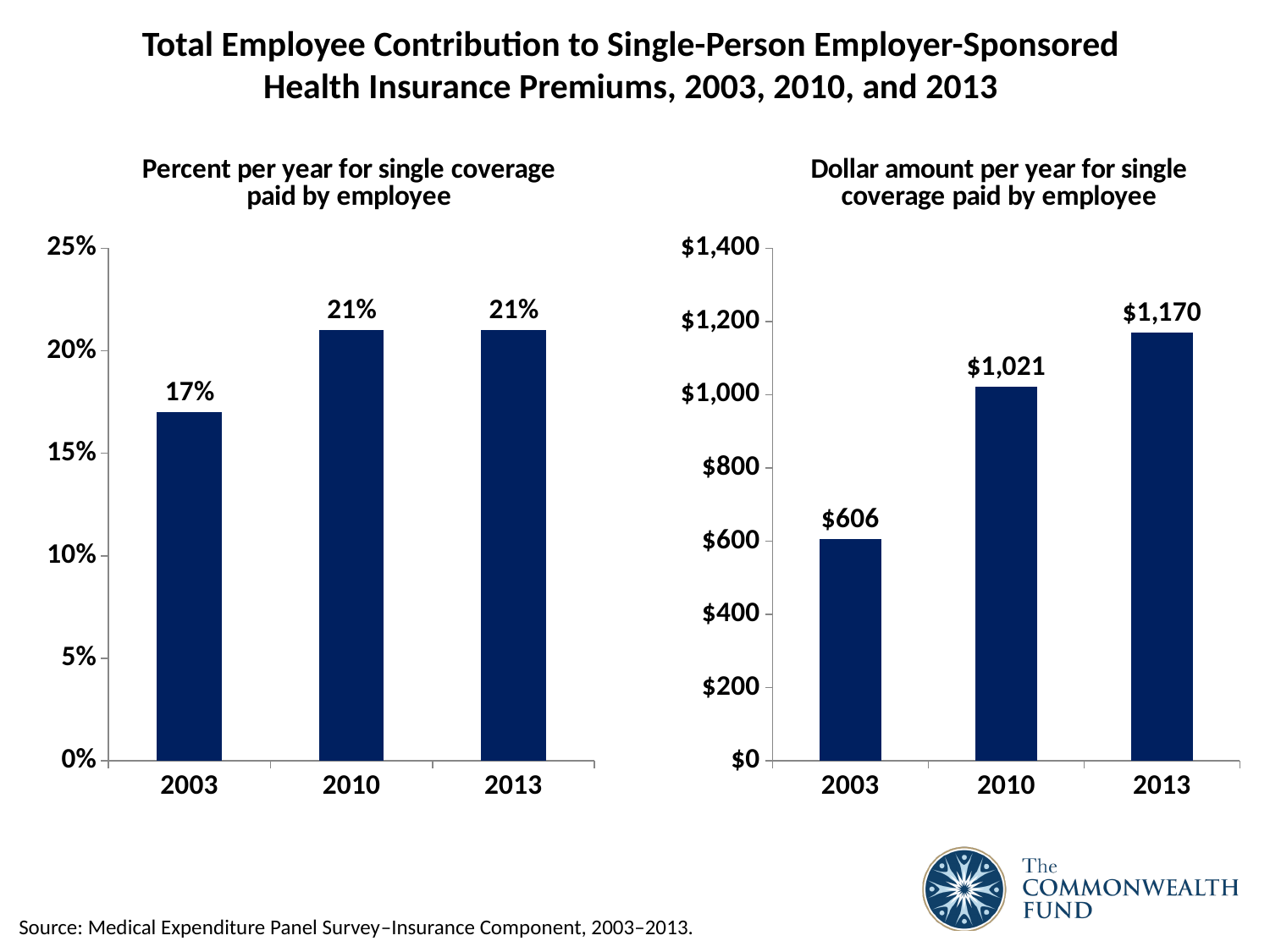
What kind of chart is the left chart (Percent per year for single coverage paid by employee)? Bar chart In the right chart (Dollar amount per year for single coverage paid by employee), do the values rise or fall from 2003 to 2013? Rise In the right chart (Dollar amount per year for single coverage paid by employee), what is the difference between the 2013 and 2003 values? $564 In the right chart (Dollar amount per year for single coverage paid by employee), what is the value for 2010? $1,021 In the right chart (Dollar amount per year for single coverage paid by employee), what is the value for 2003? $606 In the left chart (Percent per year for single coverage paid by employee), what is the value for 2013? 21% In the right chart (Dollar amount per year for single coverage paid by employee), is the value for 2010 greater or less than $1,000? greater In the right chart (Dollar amount per year for single coverage paid by employee), which year has the highest value? 2013 How many years are shown on the x axis of the right chart (Dollar amount per year for single coverage paid by employee)? 3 In the left chart (Percent per year for single coverage paid by employee), what is the value for 2003? 17% In the left chart (Percent per year for single coverage paid by employee), what is the difference between the 2010 and 2003 values? 4 percentage points In the left chart (Percent per year for single coverage paid by employee), which year has the lowest value? 2003